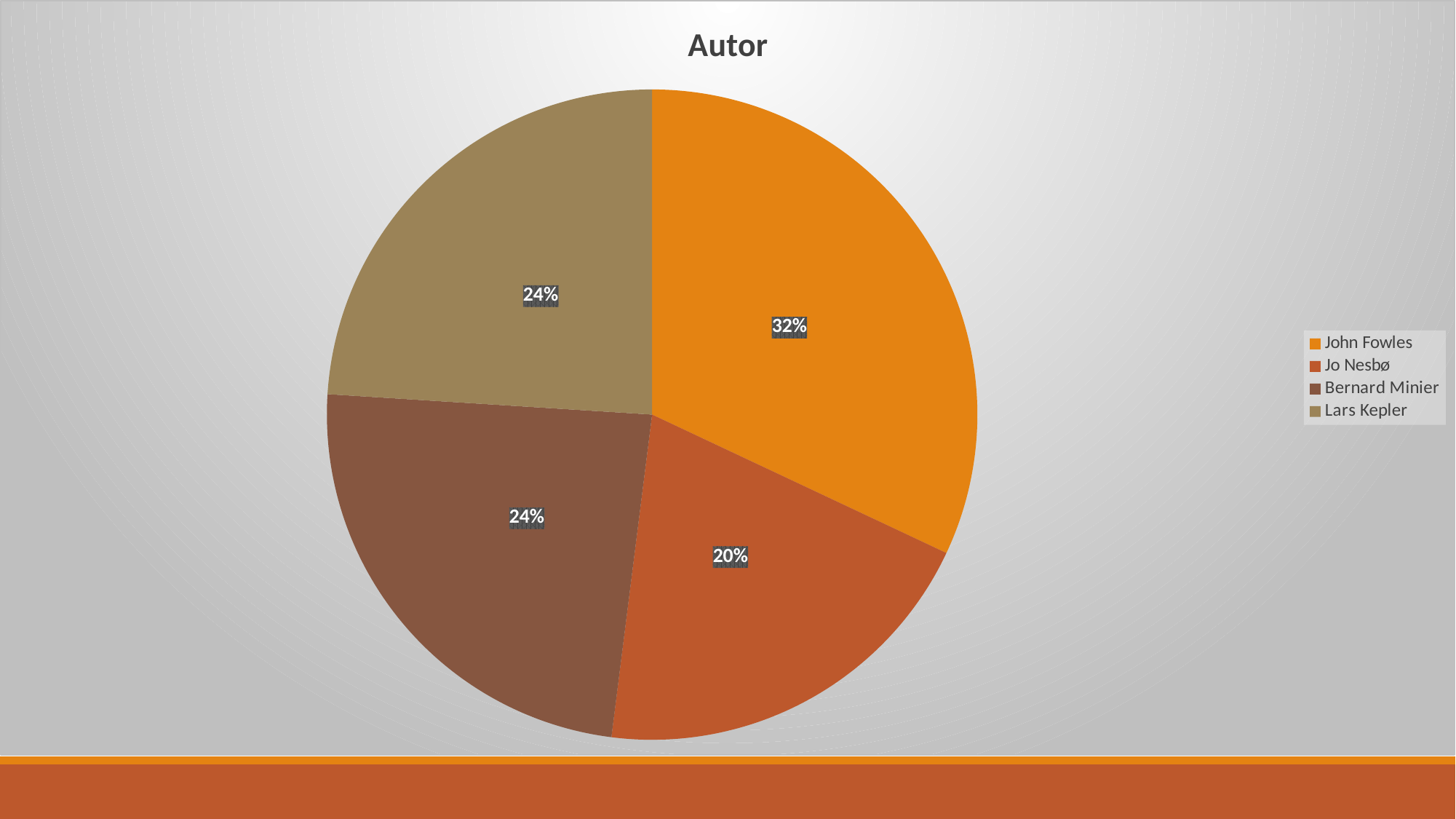
Which author has the largest slice of the pie? John Fowles What share of the pie does Bernard Minier have? 24% What is the title of the chart? Autor Which is larger, the share for John Fowles or the share for Lars Kepler? John Fowles What is the difference between the shares of John Fowles and Jo Nesbø? 12% What kind of chart is shown on the slide? pie chart How many slices does the pie chart have? 4 How many entries does the legend list? 4 What share of the pie does Jo Nesbø have? 20% What share of the pie does John Fowles have? 32% Which author has the smallest slice of the pie? Jo Nesbø